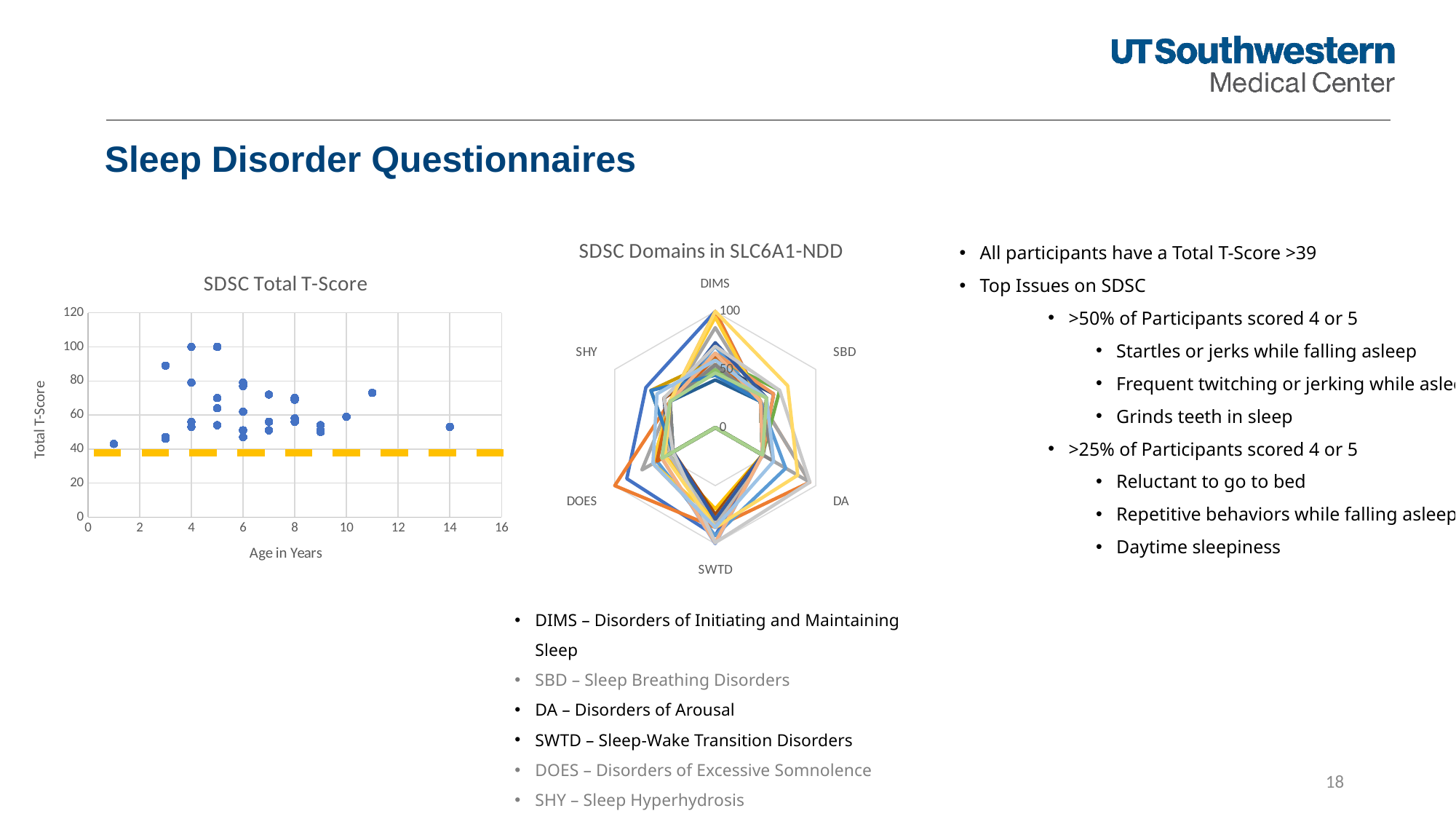
In the SDSC Total T-Score chart, what is the label of the x axis? Age in Years In the SDSC Domains in SLC6A1-NDD chart, which domain label is at the top of the radar? DIMS In the SDSC Total T-Score chart, which is larger: the value for the participant aged 11 or the participant aged 14? aged 11 In the SDSC Domains in SLC6A1-NDD chart, how many domain axes are shown? 6 What kind of chart is the SDSC Domains in SLC6A1-NDD chart? radar chart In the SDSC Total T-Score chart, what is the highest Total T-Score plotted? 100 In the SDSC Total T-Score chart, is the value for the participant aged 1 greater or less than 60? less In the SDSC Total T-Score chart, is the value for the participant aged 10 greater or less than 40? greater In the SDSC Total T-Score chart, is the value for the participant aged 14 greater or less than 60? less What kind of chart is the SDSC Total T-Score chart? scatter chart